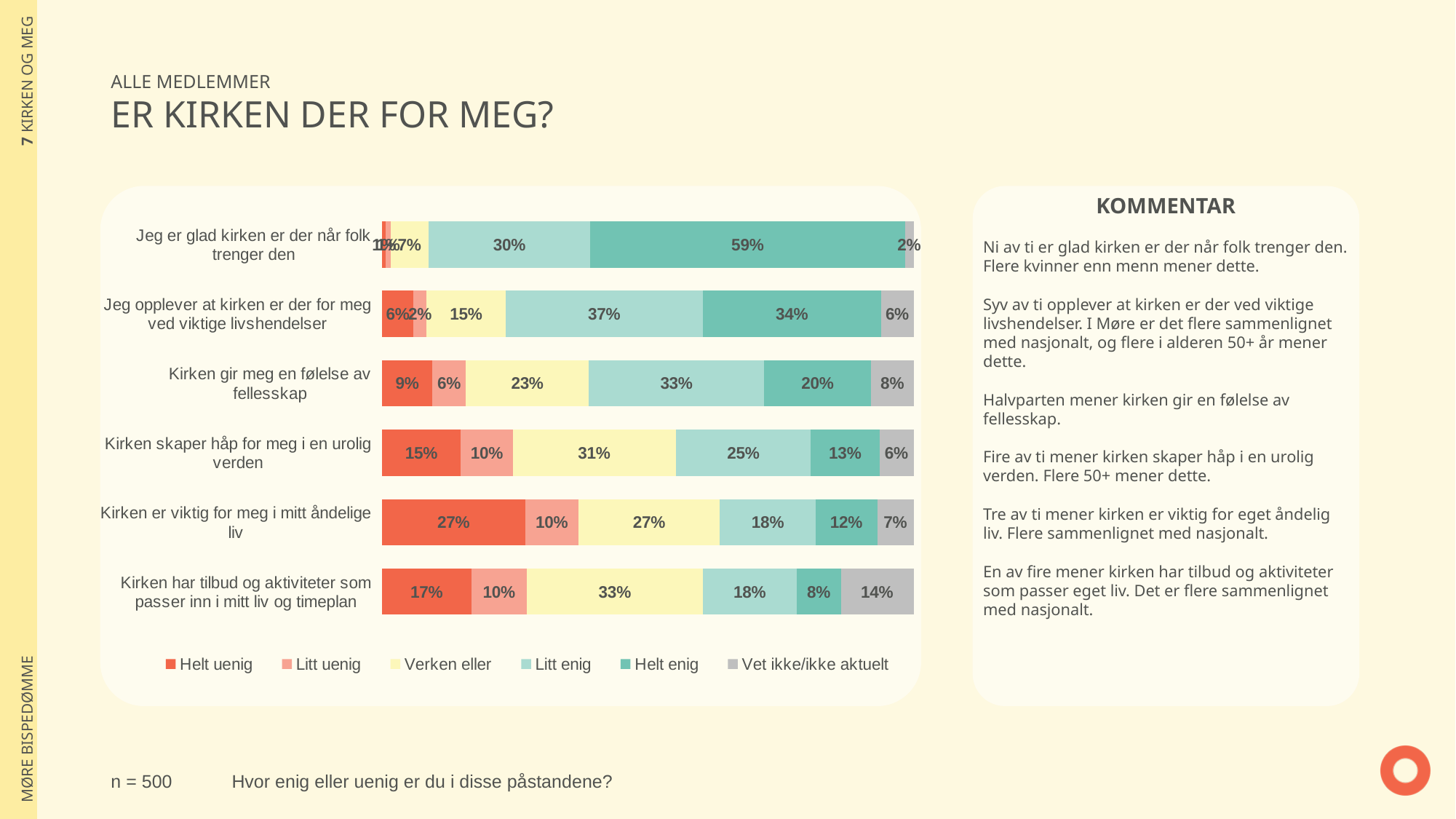
How many response categories does the legend list? 6 What type of chart is shown on the slide? Stacked bar chart What is the "Vet ikke/ikke aktuelt" value for "Kirken har tilbud og aktiviteter som passer inn i mitt liv og timeplan"? 14% Which has the larger "Verken eller" share: "Kirken gir meg en følelse av fellesskap" or "Kirken skaper håp for meg i en urolig verden"? Kirken skaper håp for meg i en urolig verden Which statement has the lowest "Helt enig" share? Kirken har tilbud og aktiviteter som passer inn i mitt liv og timeplan Which statement has the highest "Helt enig" share? Jeg er glad kirken er der når folk trenger den Which statement has the highest "Helt uenig" share? Kirken er viktig for meg i mitt åndelige liv What is the "Litt enig" value for "Jeg opplever at kirken er der for meg ved viktige livshendelser"? 37% For "Kirken skaper håp for meg i en urolig verden", what is the difference between the "Helt uenig" and "Litt uenig" shares? 5 percentage points What share answered "Helt uenig" to "Kirken er viktig for meg i mitt åndelige liv"? 27% How many statements are shown in the chart? 6 What percentage answered "Helt enig" to "Jeg er glad kirken er der når folk trenger den"? 59%